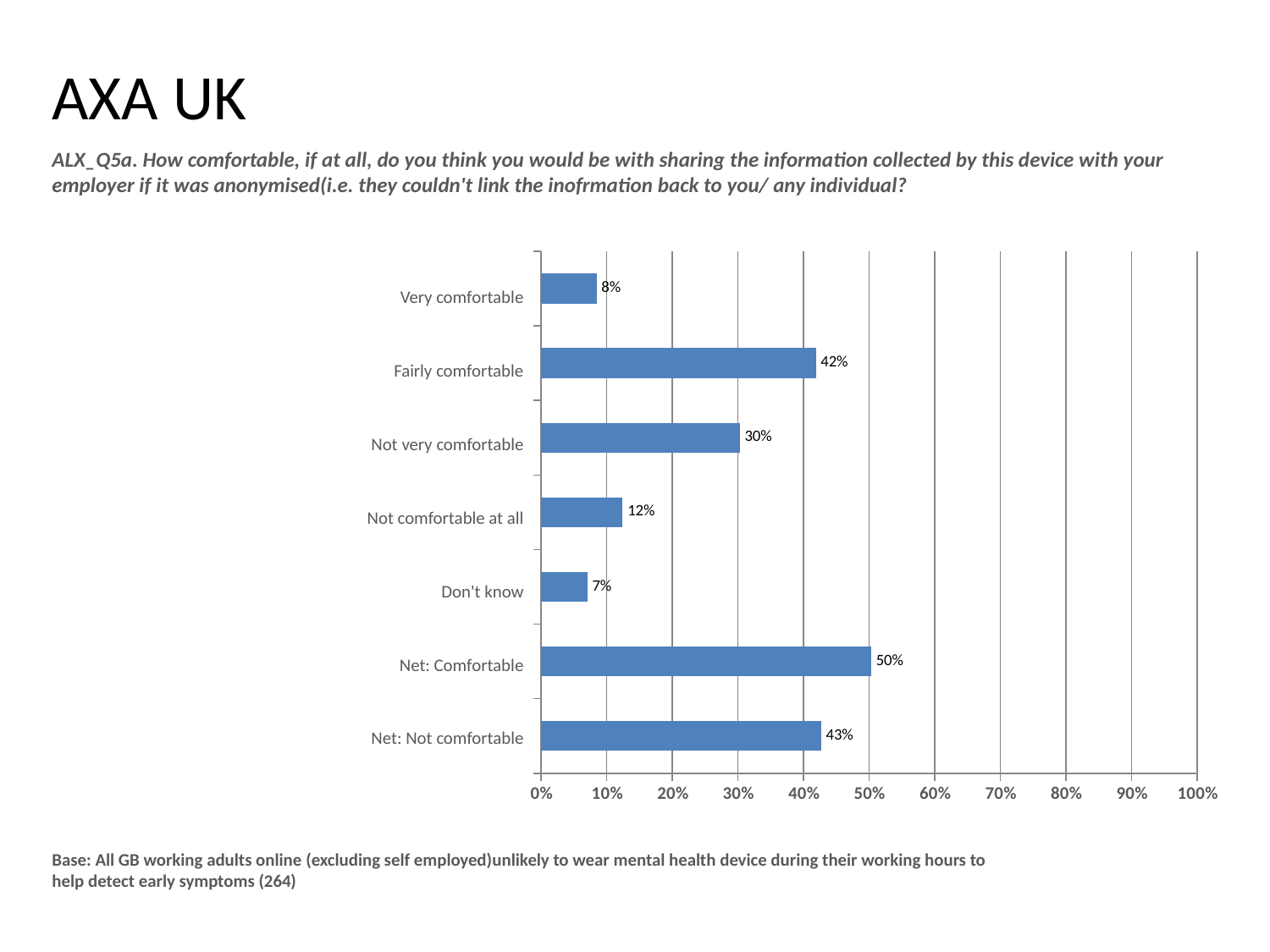
What is the value for Don't know? 7% What is the value for Not very comfortable? 30% What is the value for Fairly comfortable? 42% Which category has the lowest value? Don't know Which is larger, Very comfortable or Not comfortable at all? Not comfortable at all Is the value for Net: Not comfortable greater or less than 40%? greater How many categories are shown in the chart? 7 What kind of chart is shown on the slide? bar chart What is the difference between Fairly comfortable and Not very comfortable? 12% Which category has the highest value? Net: Comfortable What is the value for Net: Not comfortable? 43% What is the maximum value shown on the x axis? 100%